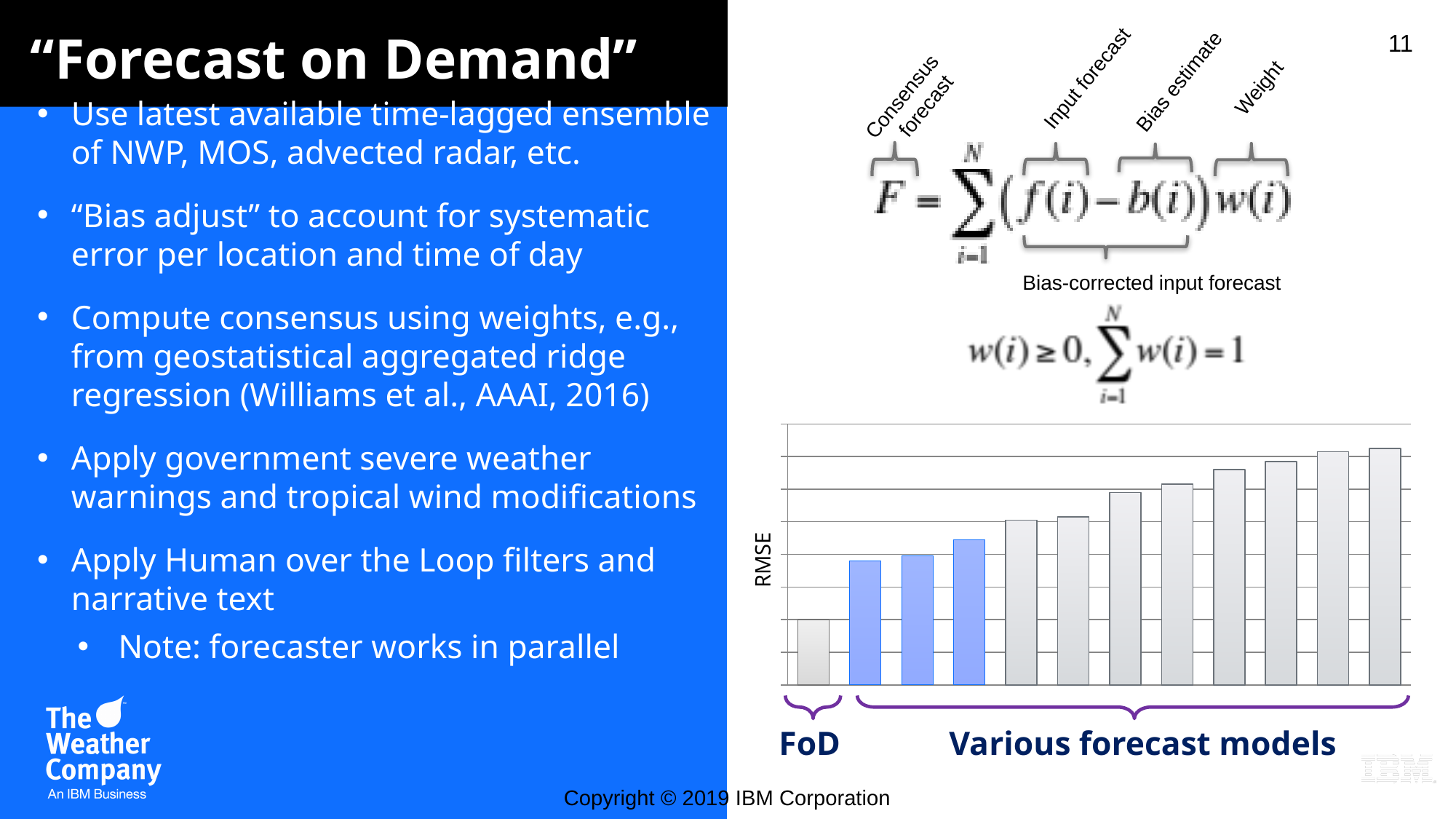
How many bars in the RMSE chart are coloured blue? 3 How many bars are plotted in the RMSE bar chart? 12 What kind of chart is shown at the bottom right of the slide? bar chart How many bars in the RMSE chart belong to the FoD group? 1 What label is given to the group of bars to the right of FoD in the bar chart? Various forecast models Do the bars in the RMSE chart rise or fall from left to right? rise Which group has the lowest RMSE in the bar chart, FoD or the various forecast models? FoD Is the RMSE of FoD larger or smaller than the RMSE of the various forecast models? smaller Which bar in the RMSE chart is the tallest, the leftmost or the rightmost? rightmost What is the label on the y axis of the bar chart? RMSE